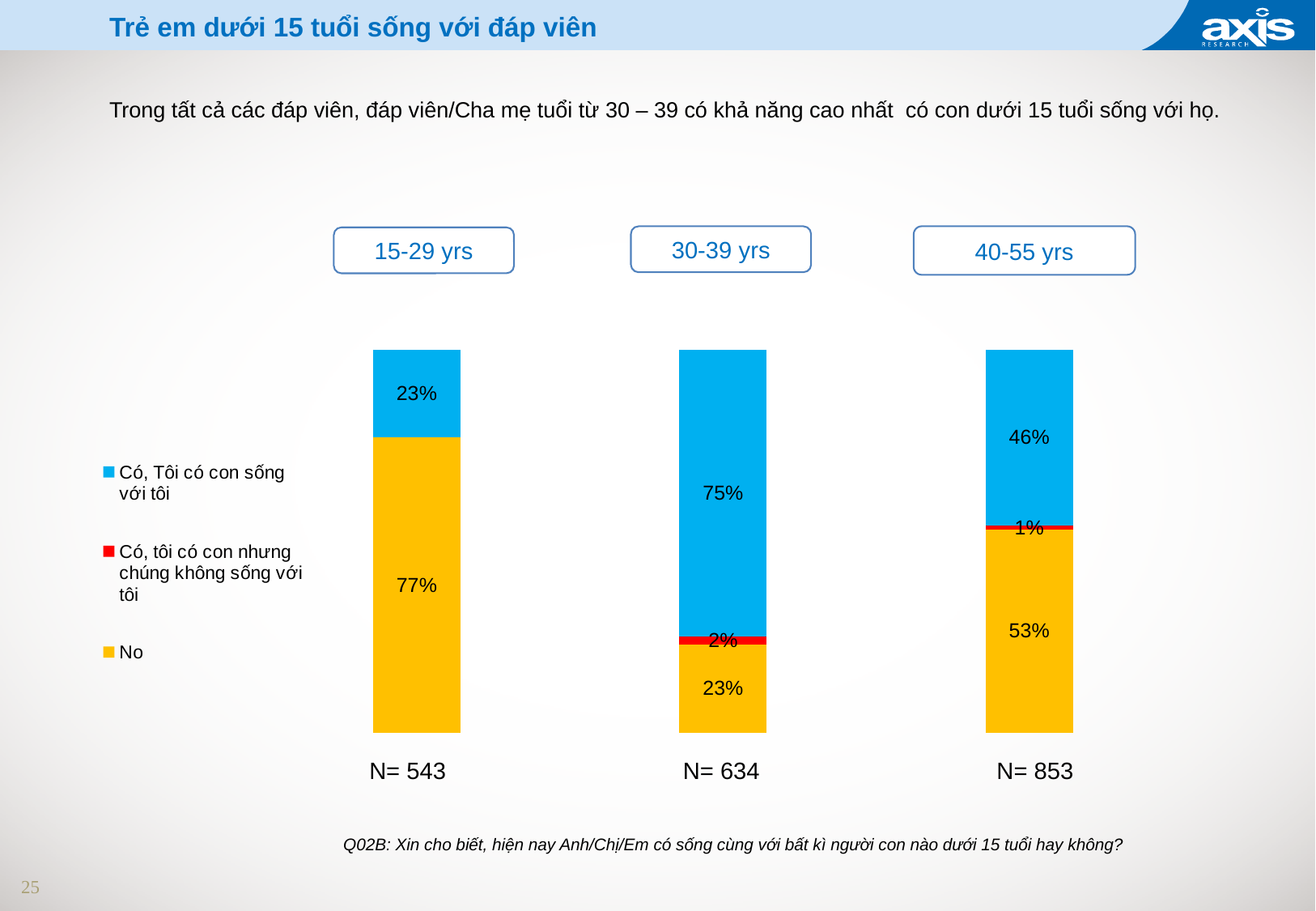
How many age groups (bars) are shown in the chart? 3 What is the value for "No" in the 15-29 yrs group? 77% What is the sample size (N) shown for the 40-55 yrs group? N= 853 What is the difference between the "No" values for the 15-29 yrs and 40-55 yrs groups? 24 percentage points Which is larger: the "Có, Tôi có con sống với tôi" value for 40-55 yrs or for 15-29 yrs? 40-55 yrs What is the value for "No" in the 30-39 yrs group? 23% Which age group has the lowest share of "No"? 30-39 yrs How many series does the legend list? 3 What is the value for "Có, Tôi có con sống với tôi" in the 30-39 yrs group? 75% What kind of chart is shown on the slide? Stacked bar chart Which age group has the highest share of "Có, Tôi có con sống với tôi"? 30-39 yrs What is the value for "Có, tôi có con nhưng chúng không sống với tôi" in the 40-55 yrs group? 1%